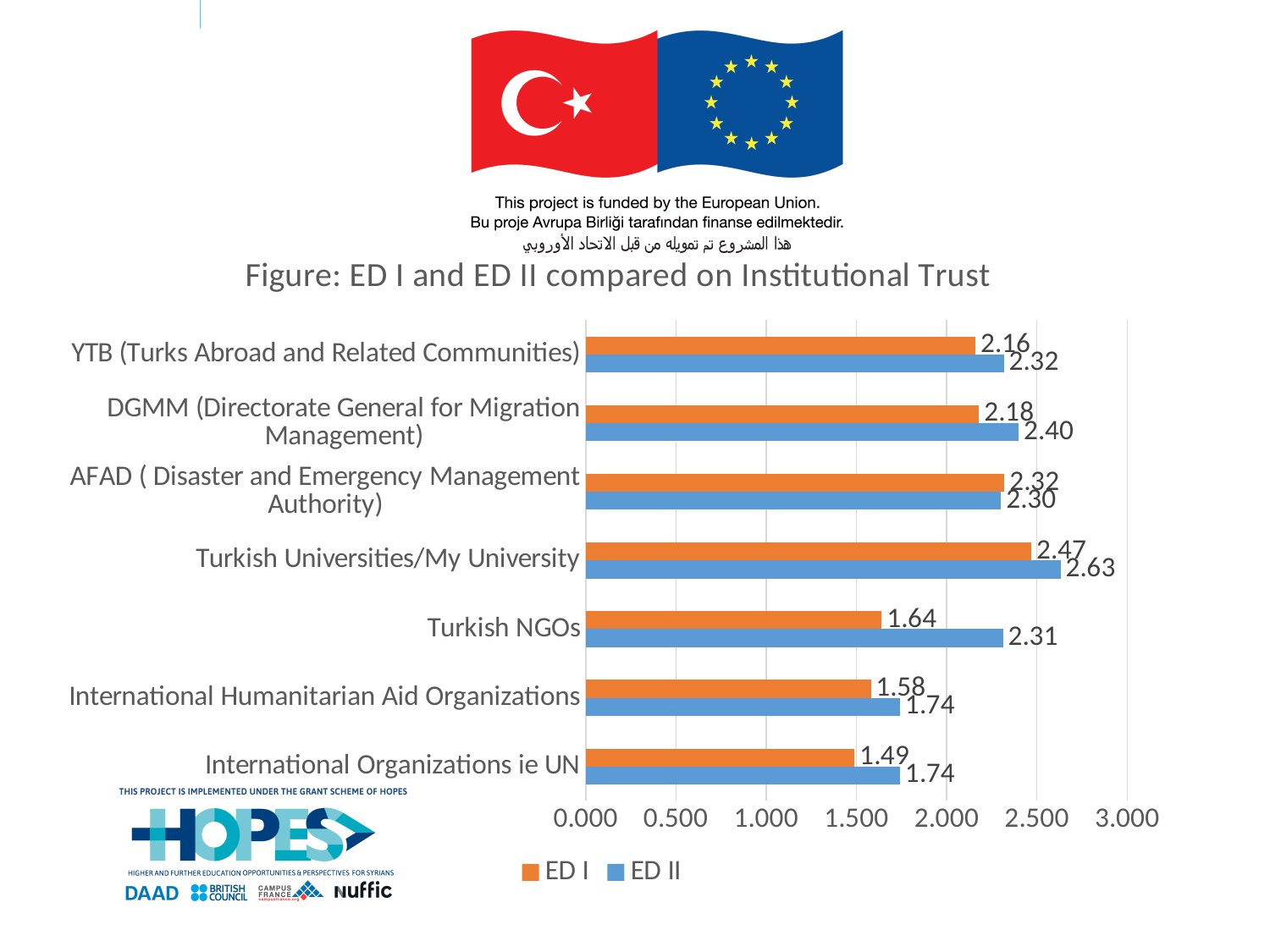
For International Humanitarian Aid Organizations, which series has the larger value, ED I or ED II? ED II Which category has the highest ED II value? Turkish Universities/My University What is the ED II value for Turkish NGOs? 2.31 What is the ED II value for DGMM (Directorate General for Migration Management)? 2.40 What is the difference between the ED II and ED I values for Turkish NGOs? 0.67 What type of chart is shown on the slide? Bar chart Is the ED I value for Turkish NGOs greater or less than 2.000? less How many series does the legend list? 2 What is the ED I value for International Organizations ie UN? 1.49 How many categories are shown on the chart? 7 Which category has the lowest ED I value? International Organizations ie UN What is the difference between the ED I values for Turkish Universities/My University and YTB (Turks Abroad and Related Communities)? 0.31